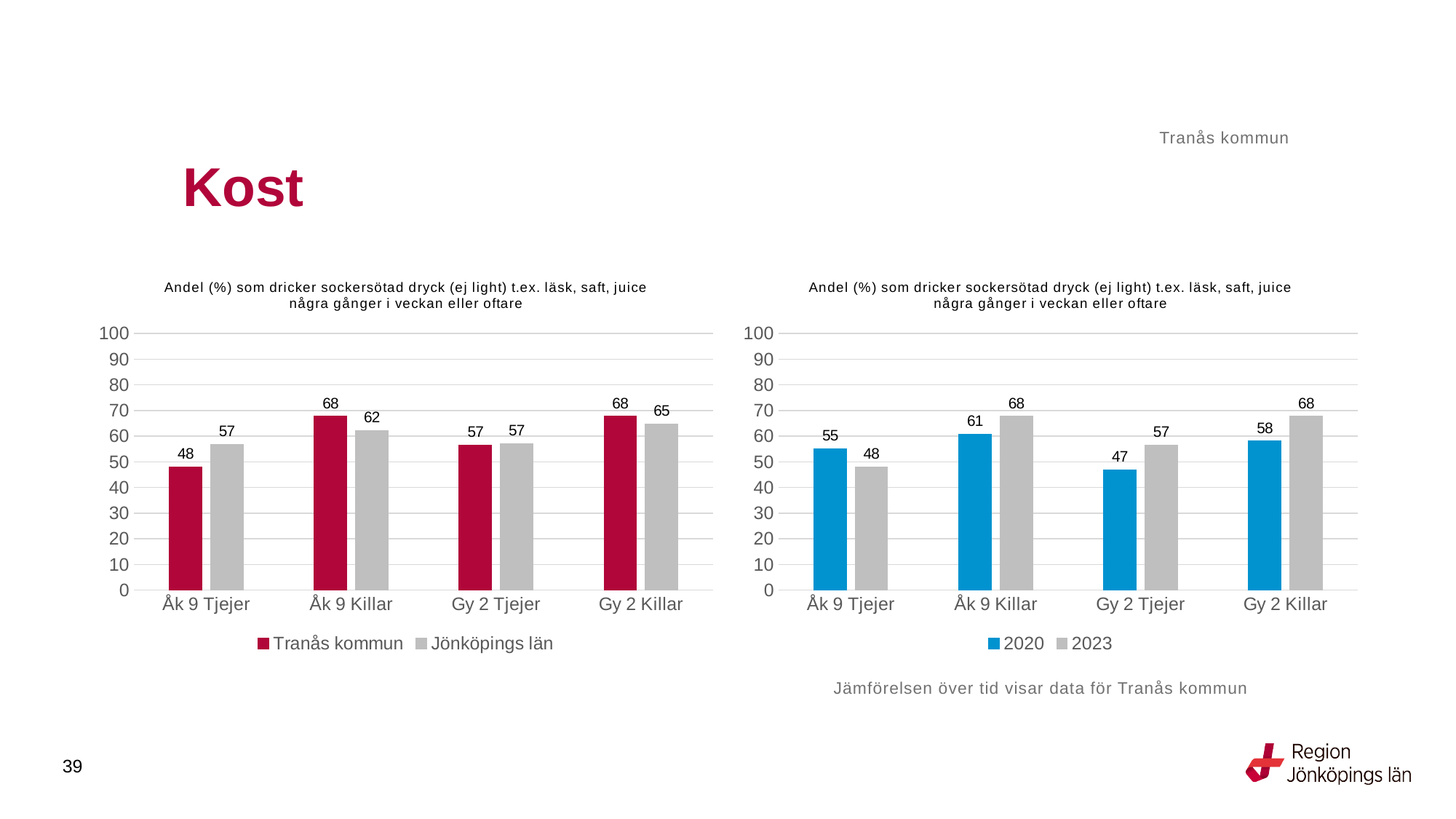
How many categories are shown on the x axis of the left chart? 4 In the right chart, what is the difference between 2023 and 2020 for Gy 2 Killar? 10 In the left chart, what is the value for Jönköpings län for Gy 2 Killar? 65 In the left chart, what is the difference between Tranås kommun and Jönköpings län for Åk 9 Killar? 6 What type of chart is the left chart? Bar chart In the left chart, which category has the lowest value for Tranås kommun? Åk 9 Tjejer In the right chart, what is the value for 2023 for Åk 9 Killar? 68 In the right chart, what is the value for 2020 for Gy 2 Tjejer? 47 In the right chart, which category has the lowest value for 2023? Åk 9 Tjejer In the right chart, which is larger for Åk 9 Tjejer, the 2020 value or the 2023 value? 2020 In the left chart, what is the value for Tranås kommun for Åk 9 Tjejer? 48 How many series does the legend of the right chart list? 2